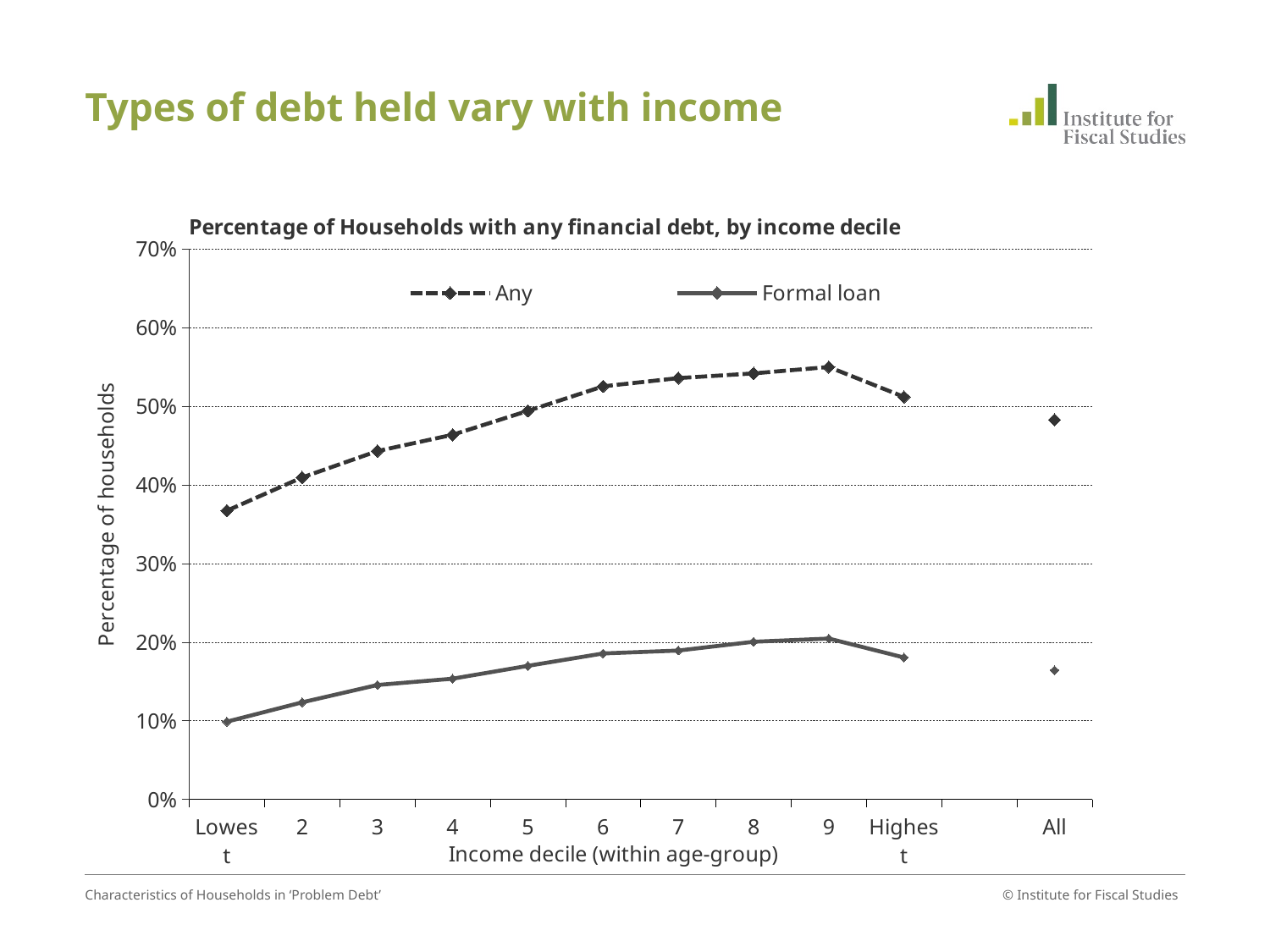
What kind of chart is shown on the slide? line chart Which income decile has the highest value for the Any series? 9 Which is larger for the Any series: the value at decile 9 or the value at the Highest decile? decile 9 Which income decile has the lowest value for the Formal loan series? Lowest Is the value for the Any series at the Lowest decile greater or less than 40%? less Is the value for the Formal loan series at the Highest decile greater or less than 20%? less Is the value for the Any series at decile 6 greater or less than 50%? greater How many categories are shown along the x axis? 11 Which income decile has the lowest value for the Any series? Lowest What is the label on the y axis? Percentage of households How many series does the legend list? 2 Does the Any series rise or fall from the Lowest decile to decile 9? rise